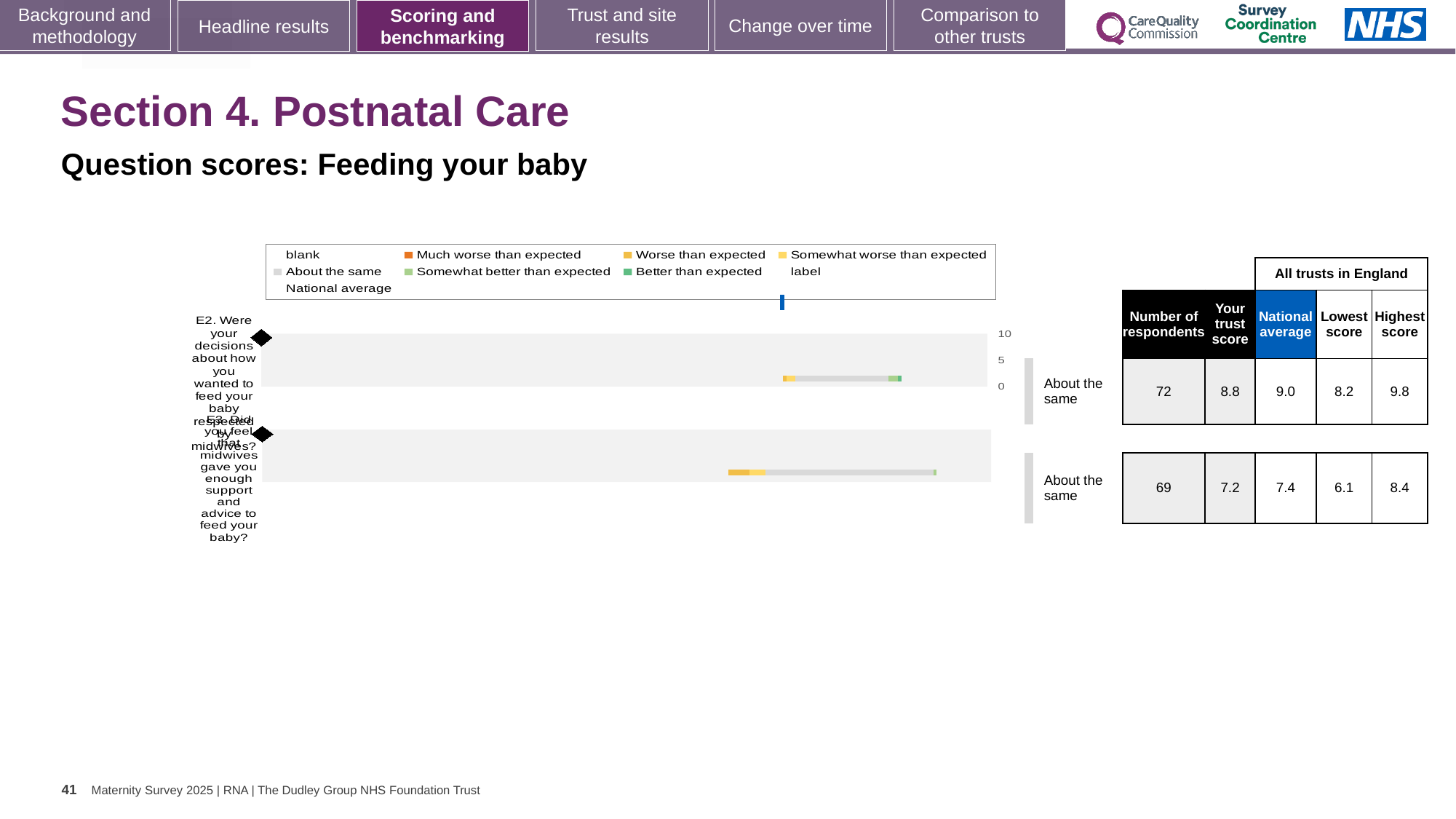
What is the difference between the national average and the trust score for question E2? 0.2 How many survey questions are plotted in the chart? 2 What is the trust score for question E2 (decisions about how you wanted to feed your baby respected by midwives)? 8.8 What is the national average for question E3 (midwives gave enough support and advice to feed your baby)? 7.4 What is the highest score across all trusts in England for question E2? 9.8 For question E3, which is larger: the trust score or the national average? the national average What is the lowest score across all trusts in England for question E3? 6.1 What kind of chart is shown on the slide? bar chart What is the difference between the highest and lowest scores for question E3? 2.3 How many respondents answered question E2? 72 What benchmark category is shown next to both questions in the chart? About the same Which question has the higher trust score, E2 or E3? E2